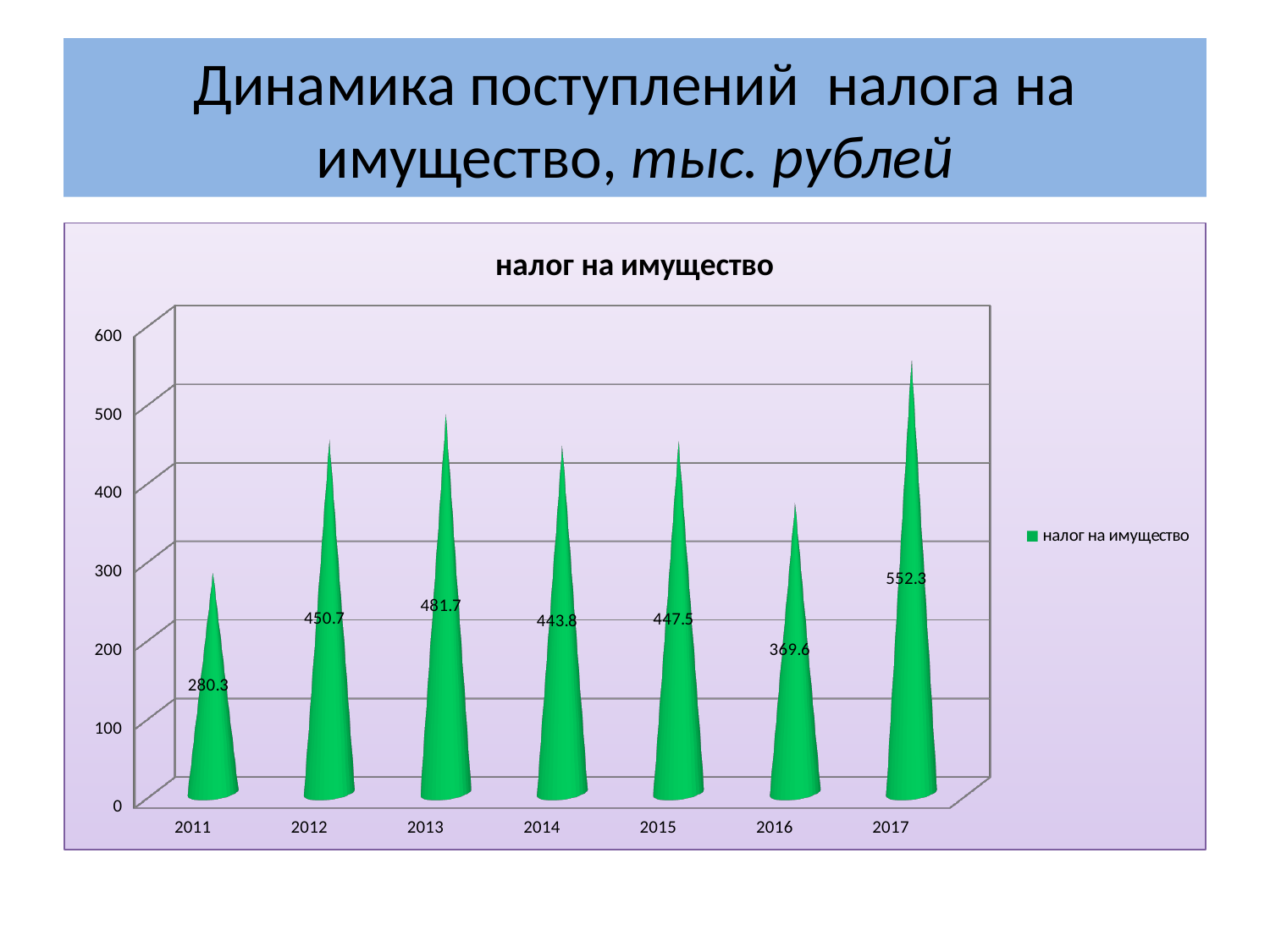
Which is larger, the value for 2015 or the value for 2014? 2015 What is the title shown inside the chart area? налог на имущество How many series does the legend list? 1 How many years are shown on the x axis? 7 What is the value for 2014? 443.8 What is the difference between the values for 2013 and 2012? 31.0 Which year has the lowest value? 2011 What is the value for 2016? 369.6 What is the difference between the values for 2017 and 2011? 272.0 Which year has the highest value? 2017 What is the value for 2011? 280.3 What kind of chart is this? bar chart